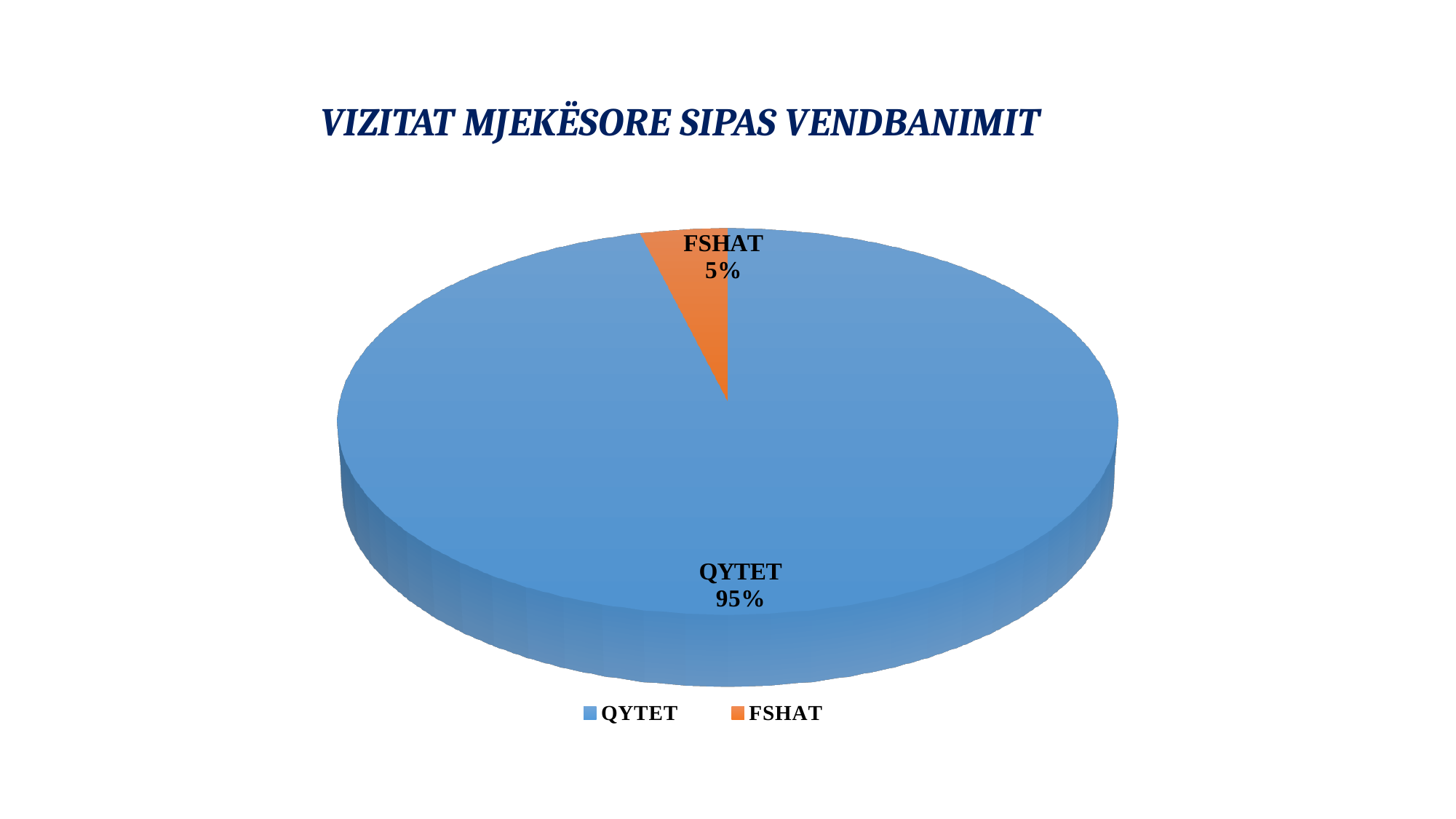
Which category has the largest slice of the pie? QYTET What share of the pie does FSHAT have? 5% How many entries does the legend list? 2 What kind of chart is shown on the slide? pie chart What colour is the FSHAT slice? orange Which slice is larger, QYTET or FSHAT? QYTET What share of the pie does QYTET have? 95% Which category has the smallest slice of the pie? FSHAT What is the difference in percentage points between the QYTET and FSHAT slices? 90 How many slices does the pie chart have? 2 What is the title of the chart? VIZITAT MJEKËSORE SIPAS VENDBANIMIT